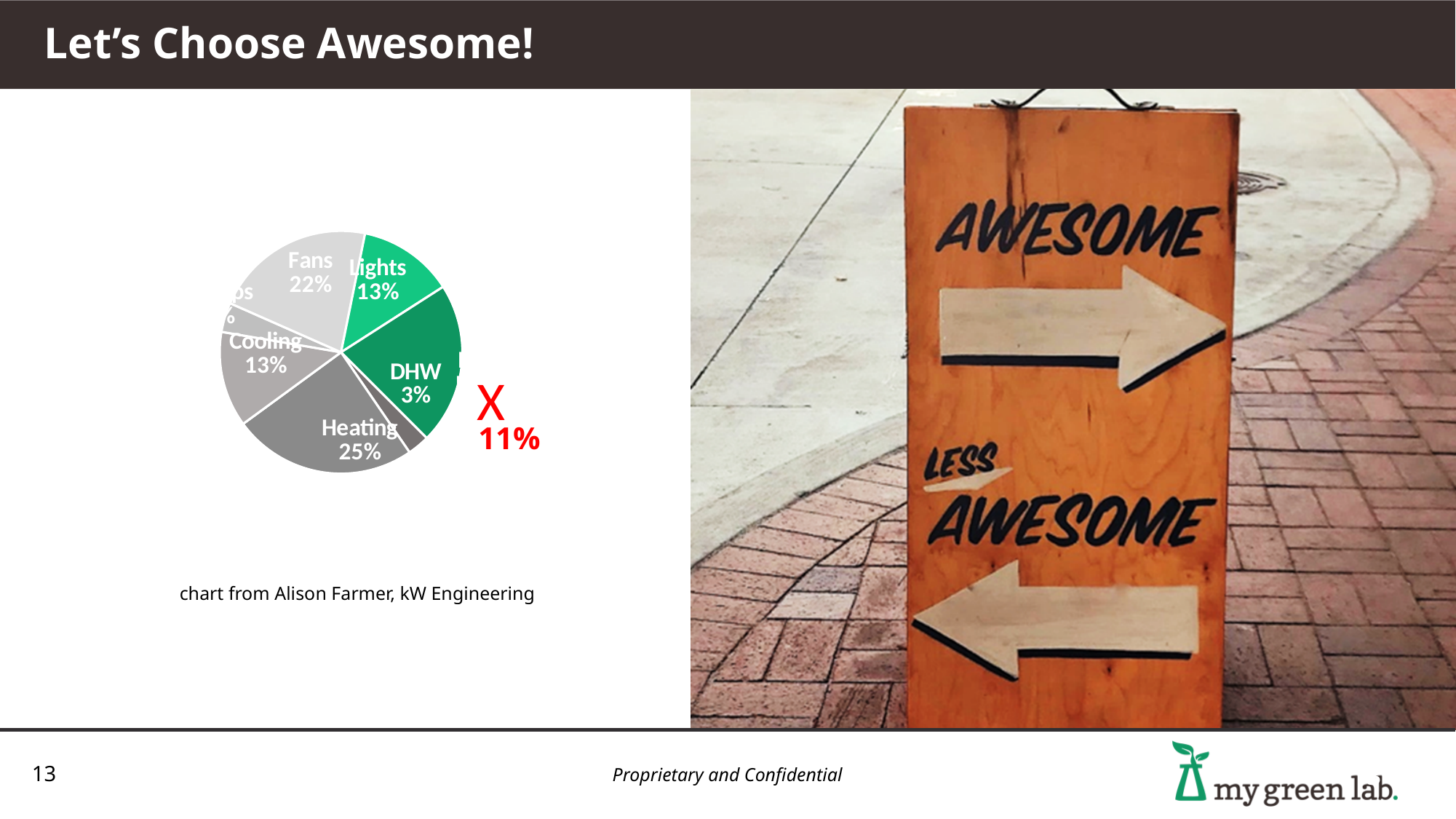
What percentage does the Fans slice of the pie chart represent? 22% What percentage does the Lights slice of the pie chart represent? 13% By how many percentage points does Heating exceed Fans in the pie chart? 3 What percentage does the DHW slice of the pie chart represent? 3% What percentage is written in red next to the pie chart with the X mark? 11% Which slice is larger in the pie chart, Fans or Cooling? Fans Which labelled slice of the pie chart has the smallest share? DHW Which labelled slice of the pie chart has the largest share? Heating What percentage does the Cooling slice of the pie chart represent? 13% What kind of chart is shown on the left of the slide? pie chart Who is credited as the source of the chart on the slide? Alison Farmer, kW Engineering What percentage does the Heating slice of the pie chart represent? 25%